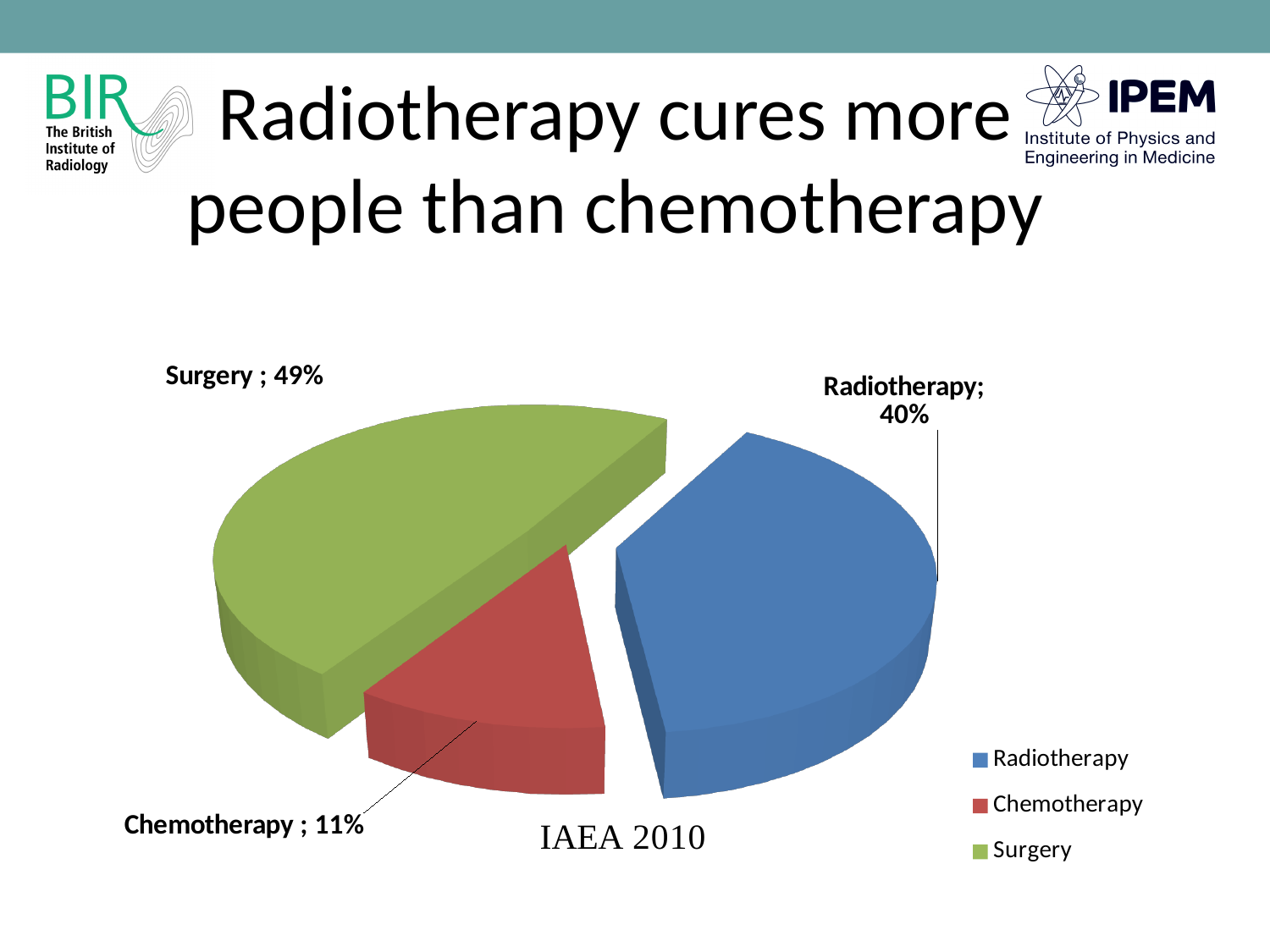
How many entries does the legend list? 3 Which category has the largest slice of the pie? Surgery What percentage does the Radiotherapy slice represent? 40% What colour is the Chemotherapy slice? Red What percentage does the Chemotherapy slice represent? 11% How many slices does the pie chart have? 3 What percentage does the Surgery slice represent? 49% Which is larger, the Radiotherapy slice or the Chemotherapy slice? Radiotherapy What is the difference in percentage points between the Radiotherapy and Chemotherapy slices? 29 What is the difference in percentage points between the Surgery and Radiotherapy slices? 9 What kind of chart is shown on the slide? Pie chart Which category has the smallest slice of the pie? Chemotherapy